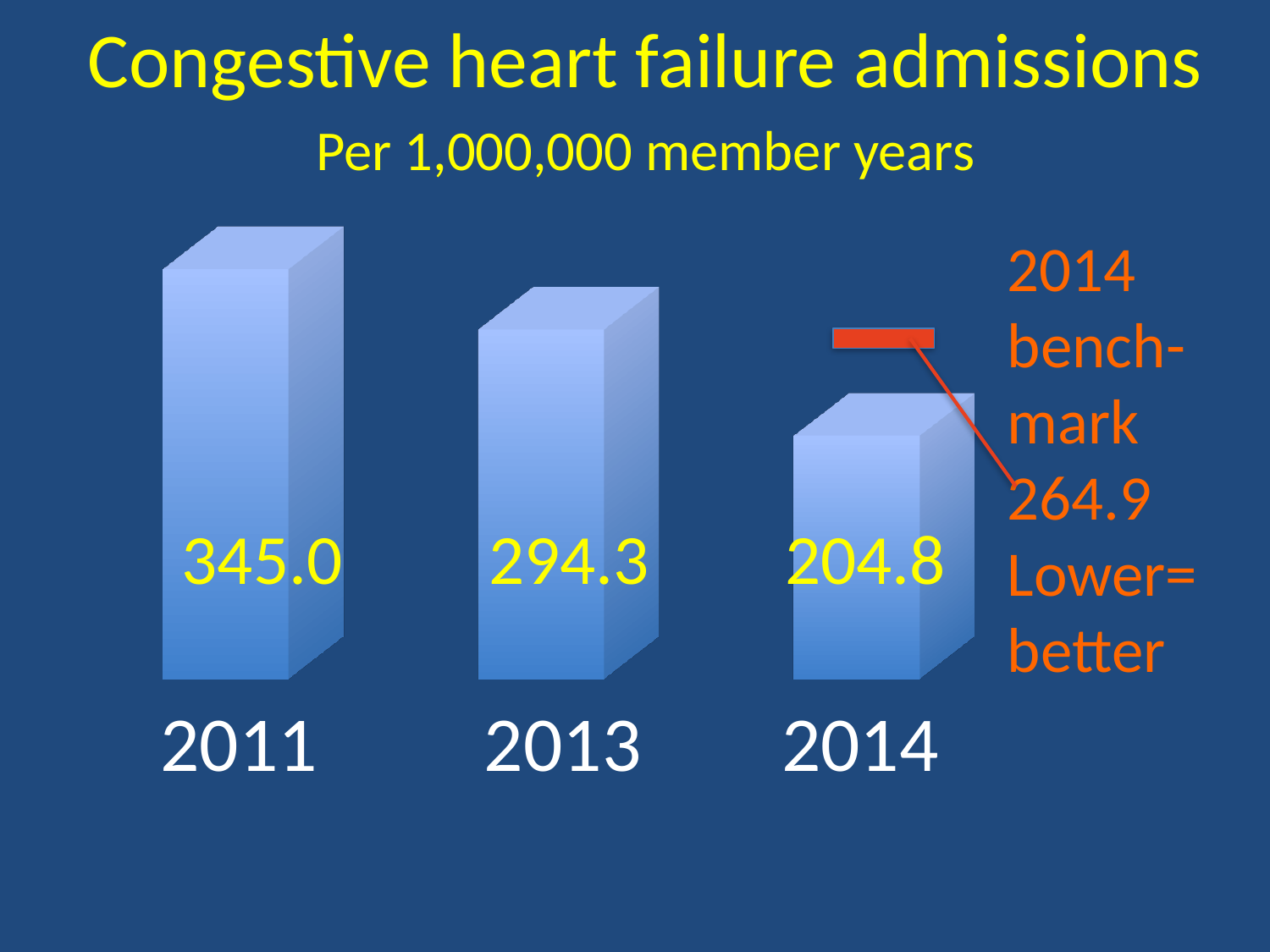
What is the 2014 benchmark value shown on the slide? 264.9 What is the value for 2011? 345.0 Which is larger, the value for 2013 or the value for 2014? 2013 What is the value for 2013? 294.3 Which year has the lowest value? 2014 What is the difference between the 2013 and 2014 values? 89.5 Do the values rise or fall from 2011 to 2014? fall What is the value for 2014? 204.8 How many years are shown in the chart? 3 What kind of chart is this? bar chart What is the difference between the 2011 and 2014 values? 140.2 Which year has the highest value? 2011